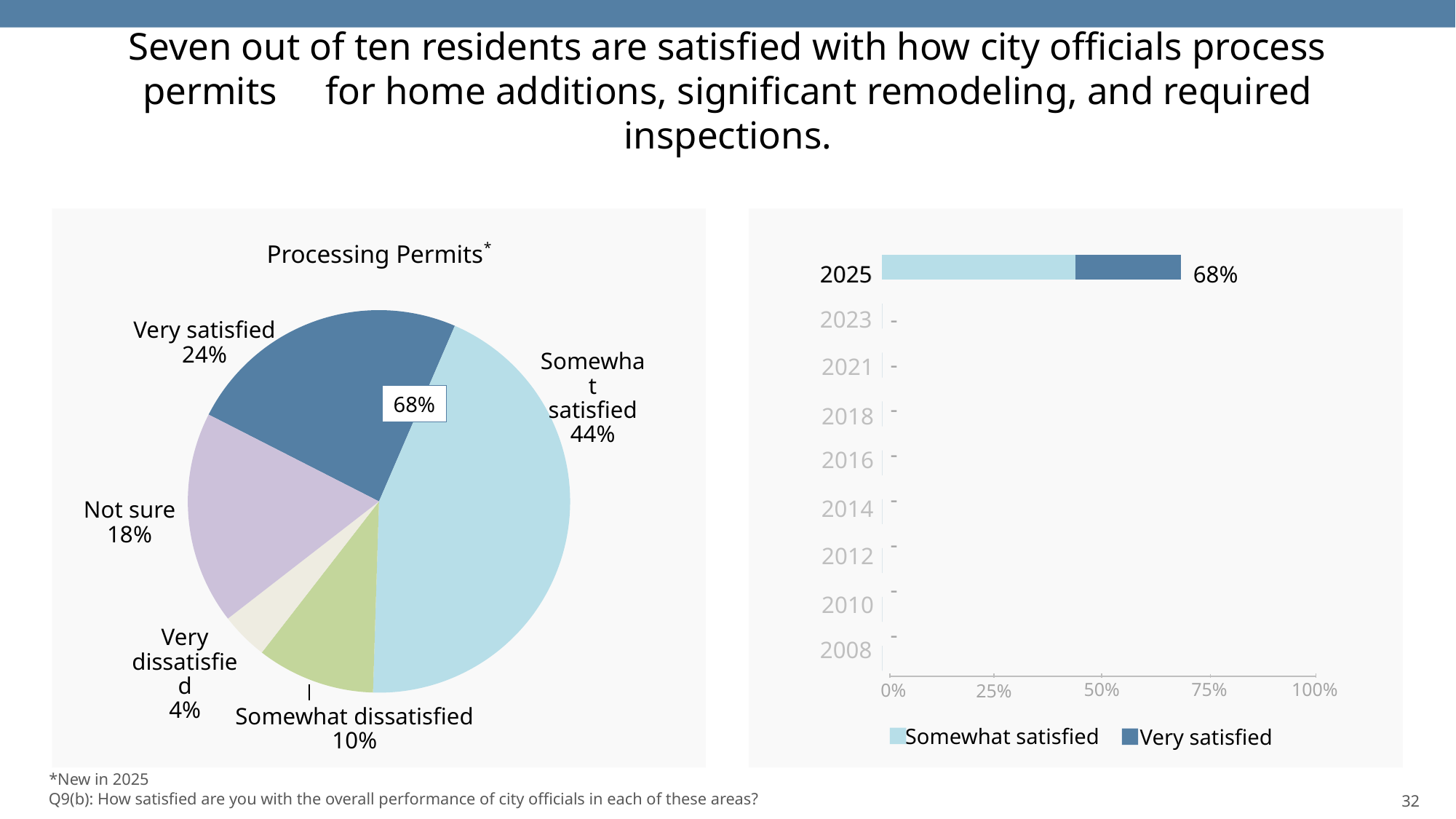
In the bar chart on the right, what is the total satisfied value labeled for 2025? 68% What type of chart is the chart on the right side of the slide? Bar chart In the Processing Permits pie chart, what is the difference between the Somewhat satisfied and Very satisfied shares? 20% In the Processing Permits pie chart, what percentage of residents answered Not sure? 18% How many series does the legend of the bar chart on the right list? 2 In the Processing Permits pie chart, which category has the largest share? Somewhat satisfied In the Processing Permits pie chart, what percentage of residents are somewhat satisfied? 44% In the Processing Permits pie chart, what percentage of residents are very satisfied? 24% In the Processing Permits pie chart, which category has the smallest share? Very dissatisfied In the Processing Permits pie chart, what percentage of residents are very dissatisfied? 4% How many slices does the Processing Permits pie chart have? 5 In the Processing Permits pie chart, which is larger: Not sure or Somewhat dissatisfied? Not sure